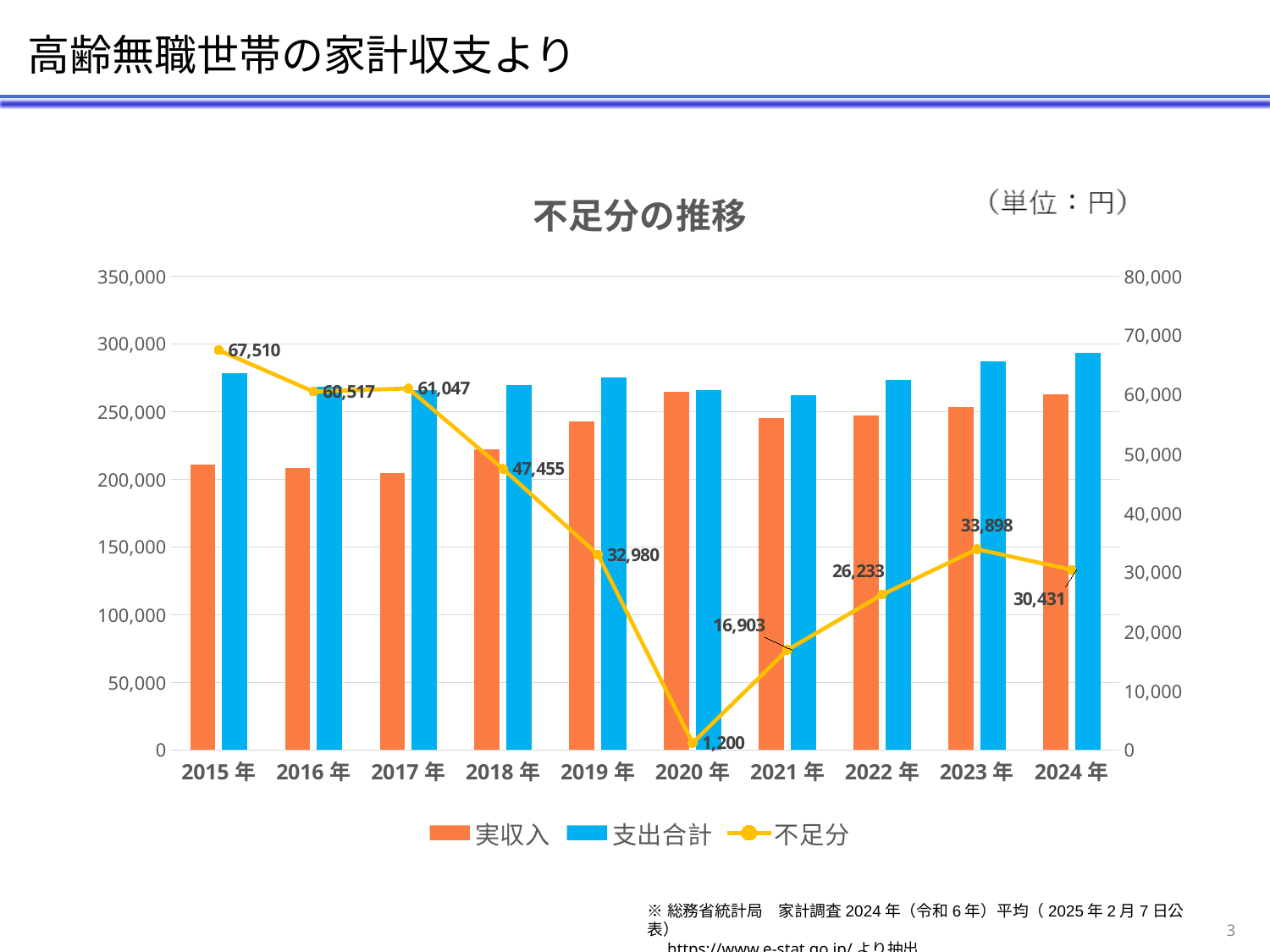
Does 不足分 rise or fall from 2015年 to 2020年? Fall What is the difference between 不足分 in 2015年 and 2016年? 6,993 Which year has the larger 不足分, 2023年 or 2024年? 2023年 In which year is 不足分 highest? 2015年 What is the value of 不足分 for 2023年? 33,898 How many series does the legend list? 3 How many years are shown on the x axis? 10 What is the value of 不足分 for 2015年? 67,510 What is the value of 不足分 for 2020年? 1,200 In which year is 不足分 lowest? 2020年 Is the value of 支出合計 for 2024年 greater or less than 250,000? greater What kind of chart is this? Combination bar and line chart